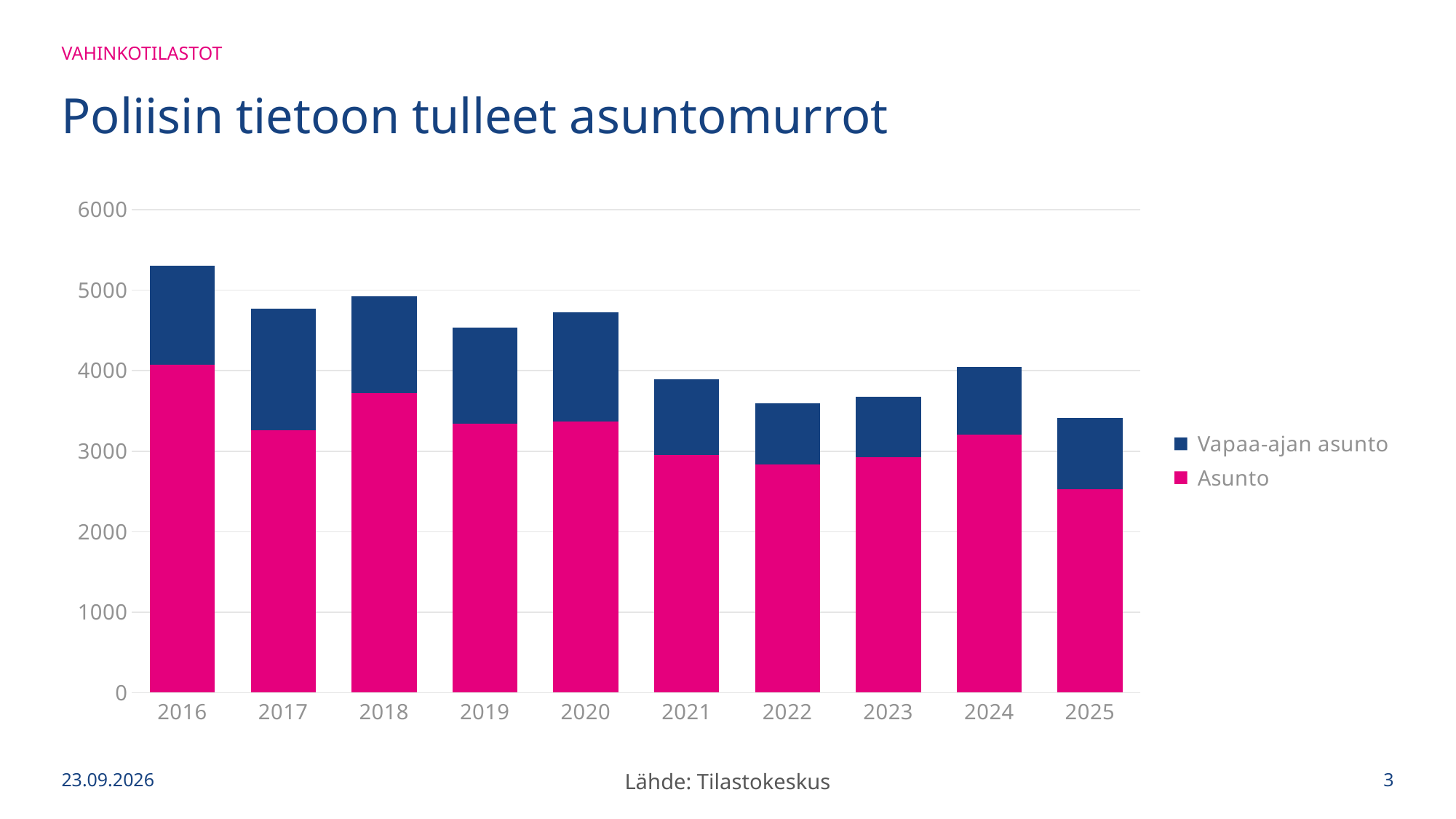
How many series does the legend list? 2 Is the total bar for 2021 greater or less than 4000? less Which year has the highest total bar? 2016 Do the total values generally rise or fall from 2016 to 2025? fall Which year has the lowest value for Asunto? 2025 Which is larger, the Asunto value for 2018 or for 2017? 2018 Is the total bar for 2016 greater or less than 5000? greater Which series is shown in dark blue in the legend? Vapaa-ajan asunto Is the value for Asunto in 2025 greater or less than 3000? less Which year has the lowest total bar? 2025 What kind of chart is shown on the slide? Stacked bar chart How many years are shown on the x axis of the chart? 10